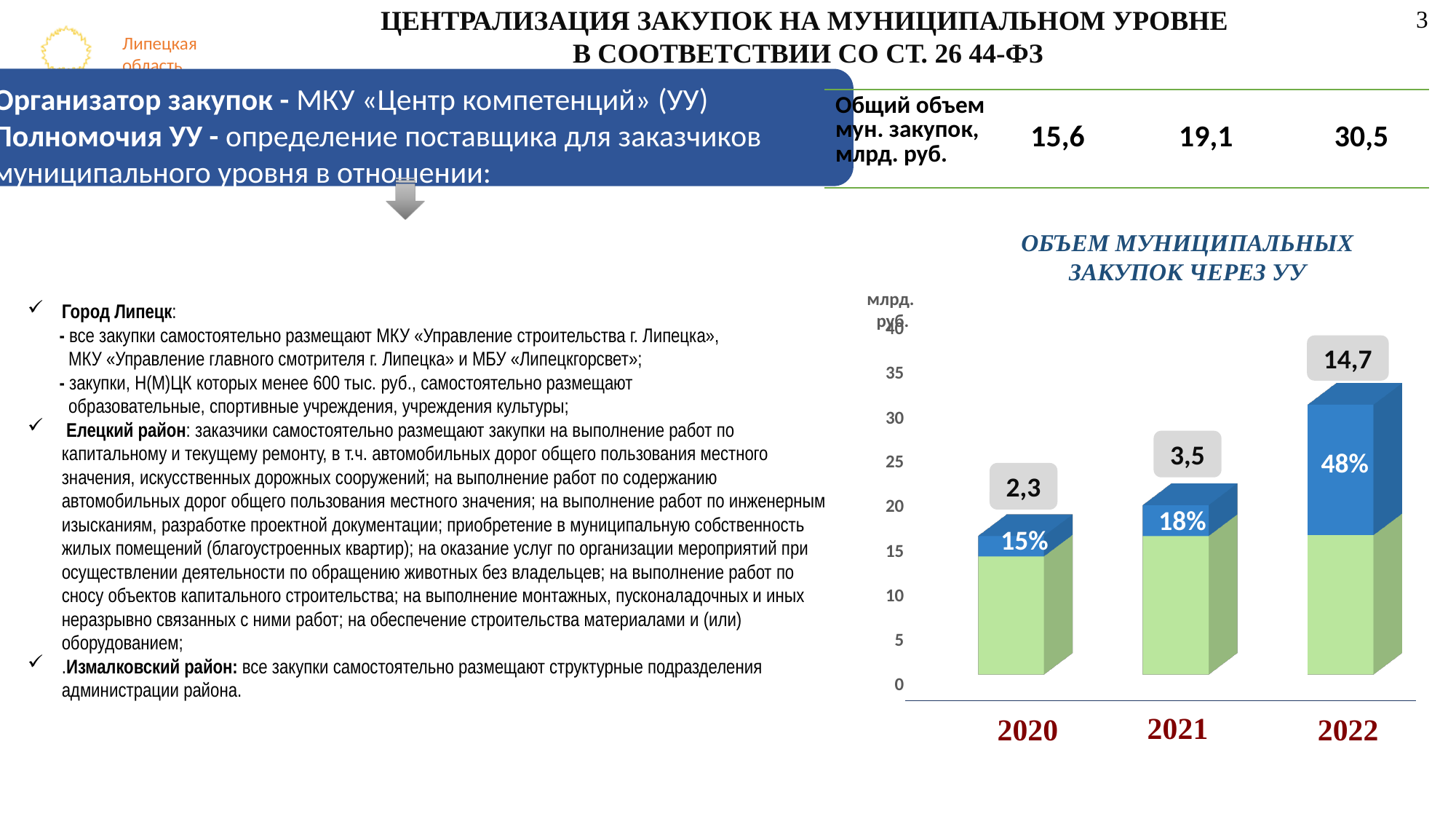
What is the value labelled on the bar for 2022 in the chart 'ОБЪЕМ МУНИЦИПАЛЬНЫХ ЗАКУПОК ЧЕРЕЗ УУ'? 14,7 Which year has the highest labelled value in the chart? 2022 What is the value labelled on the bar for 2020? 2,3 What is the value labelled on the bar for 2021? 3,5 What kind of chart is 'ОБЪЕМ МУНИЦИПАЛЬНЫХ ЗАКУПОК ЧЕРЕЗ УУ'? bar chart Which year has the lowest labelled value in the chart? 2020 Do the labelled values rise or fall from 2020 to 2022? rise What is the difference between the labelled values for 2022 and 2020? 12,4 What percentage is shown on the blue segment of the 2020 bar? 15% What percentage is shown on the blue segment of the 2022 bar? 48% Which is larger, the percentage shown for 2021 or for 2020? 2021 How many years are shown on the x axis of the chart? 3